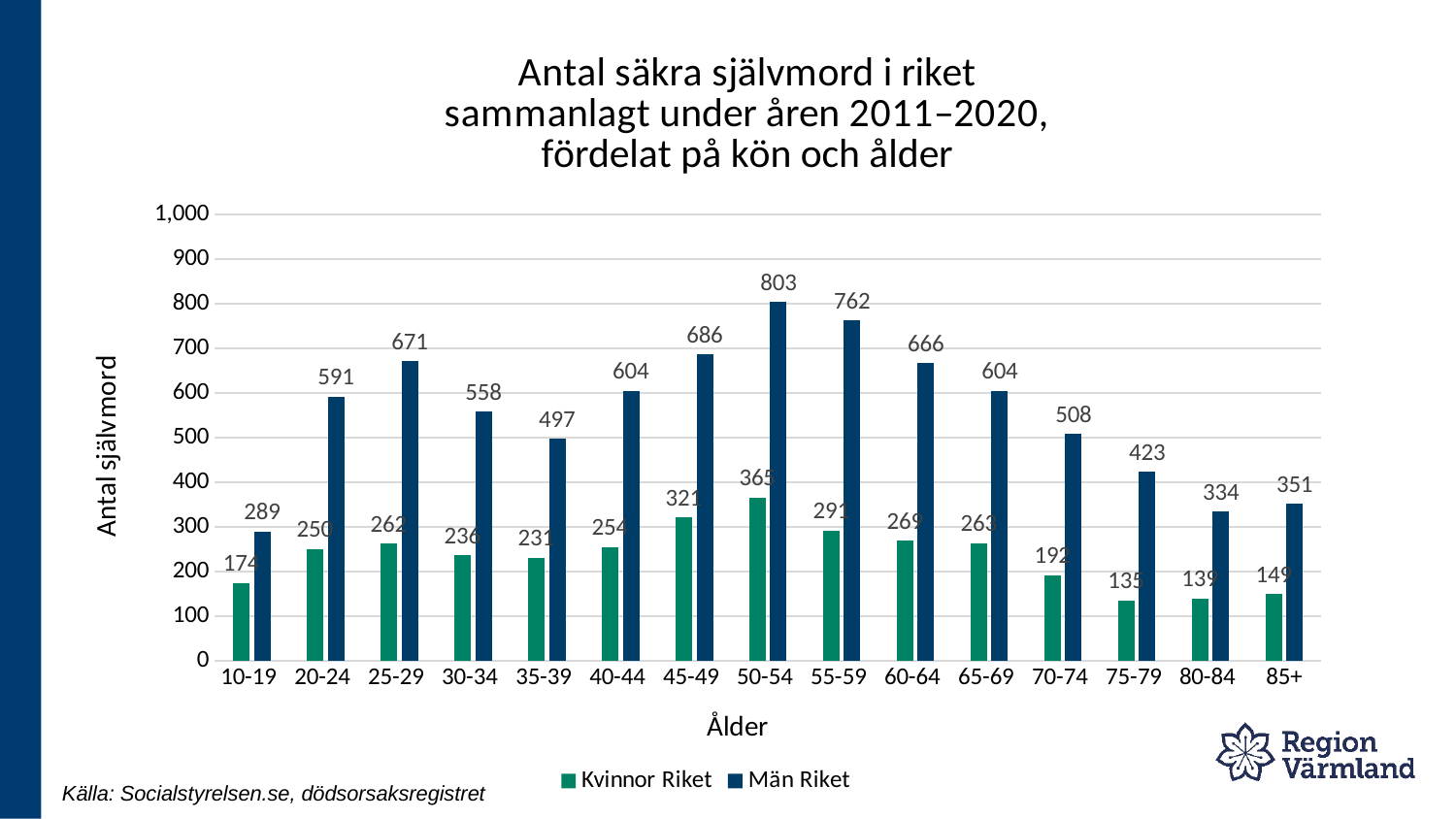
What is the value for Kvinnor Riket in the 10-19 age group? 174 What is the label of the y axis? Antal självmord How many age groups are shown on the x axis? 15 What is the difference between Män Riket and Kvinnor Riket in the 25-29 age group? 409 What kind of chart is shown on the slide? Bar chart Which age group has the lowest value for Kvinnor Riket? 75-79 How many series does the legend list? 2 Is the value for Män Riket in the 35-39 age group greater or less than 500? less Which age group has the highest value for Kvinnor Riket? 50-54 Which is larger: Män Riket for 55-59 or Män Riket for 60-64? Män Riket for 55-59 What is the value for Män Riket in the 50-54 age group? 803 Which age group has the lowest value for Män Riket? 10-19